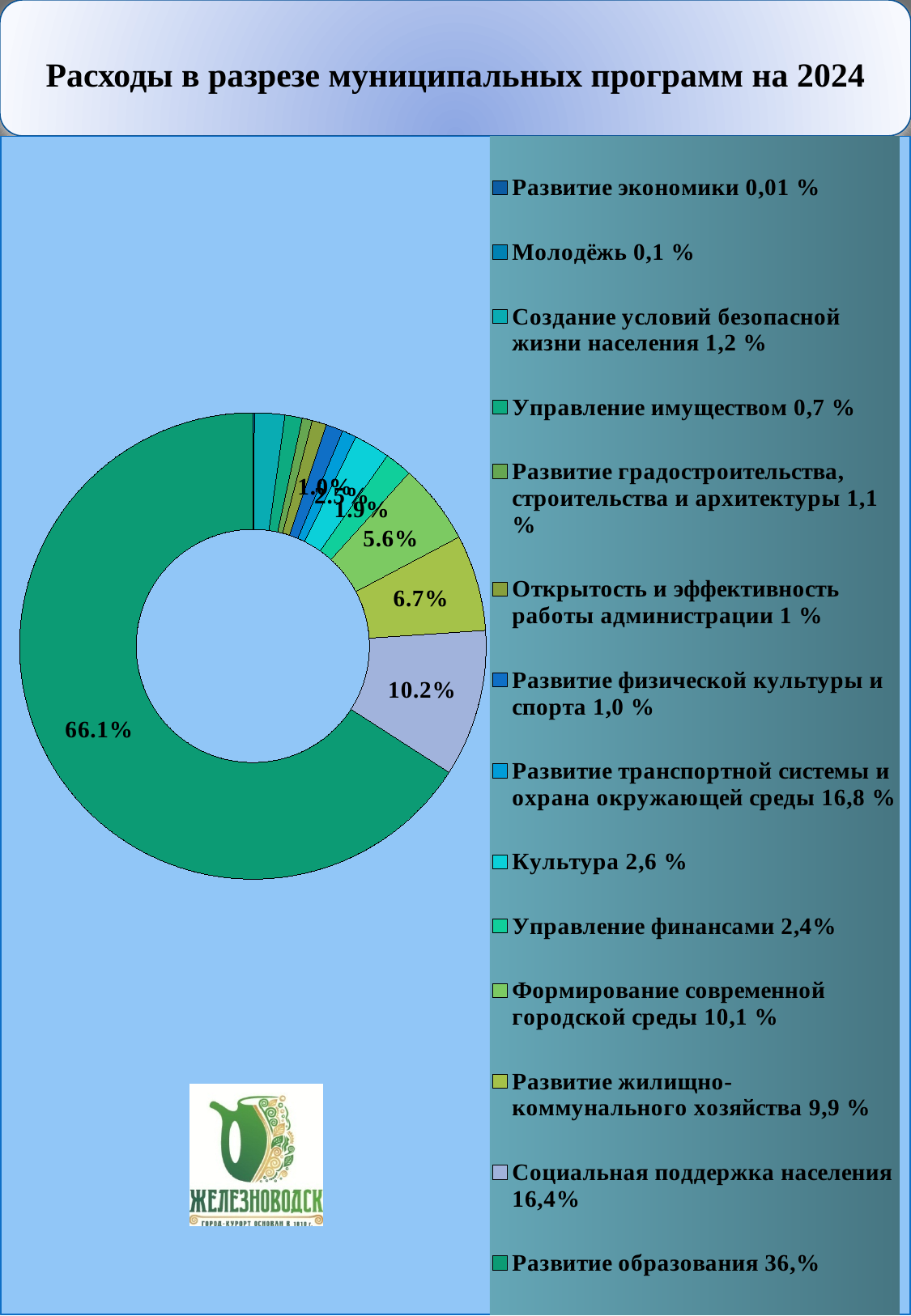
According to the legend, what percentage is given for Молодёжь? 0,1 % What is the data label on the largest slice of the doughnut chart? 66.1% What kind of chart is shown on the slide? doughnut (pie) chart What is the data label on the second-largest slice of the doughnut chart? 10.2% How many entries does the chart legend list? 14 According to the legend, what percentage is given for Культура? 2,6 % According to the legend, what percentage is given for Развитие экономики? 0,01 % What is the difference between the slices labelled 10.2% and 6.7%? 3.5 percentage points According to the legend, what percentage is given for Социальная поддержка населения? 16,4% What is the title of the chart on the slide? Расходы в разрезе муниципальных программ на 2024 Which slice is larger: the one labelled 10.2% or the one labelled 6.7%? 10.2% According to the legend, what percentage is given for Развитие транспортной системы и охрана окружающей среды? 16,8 %